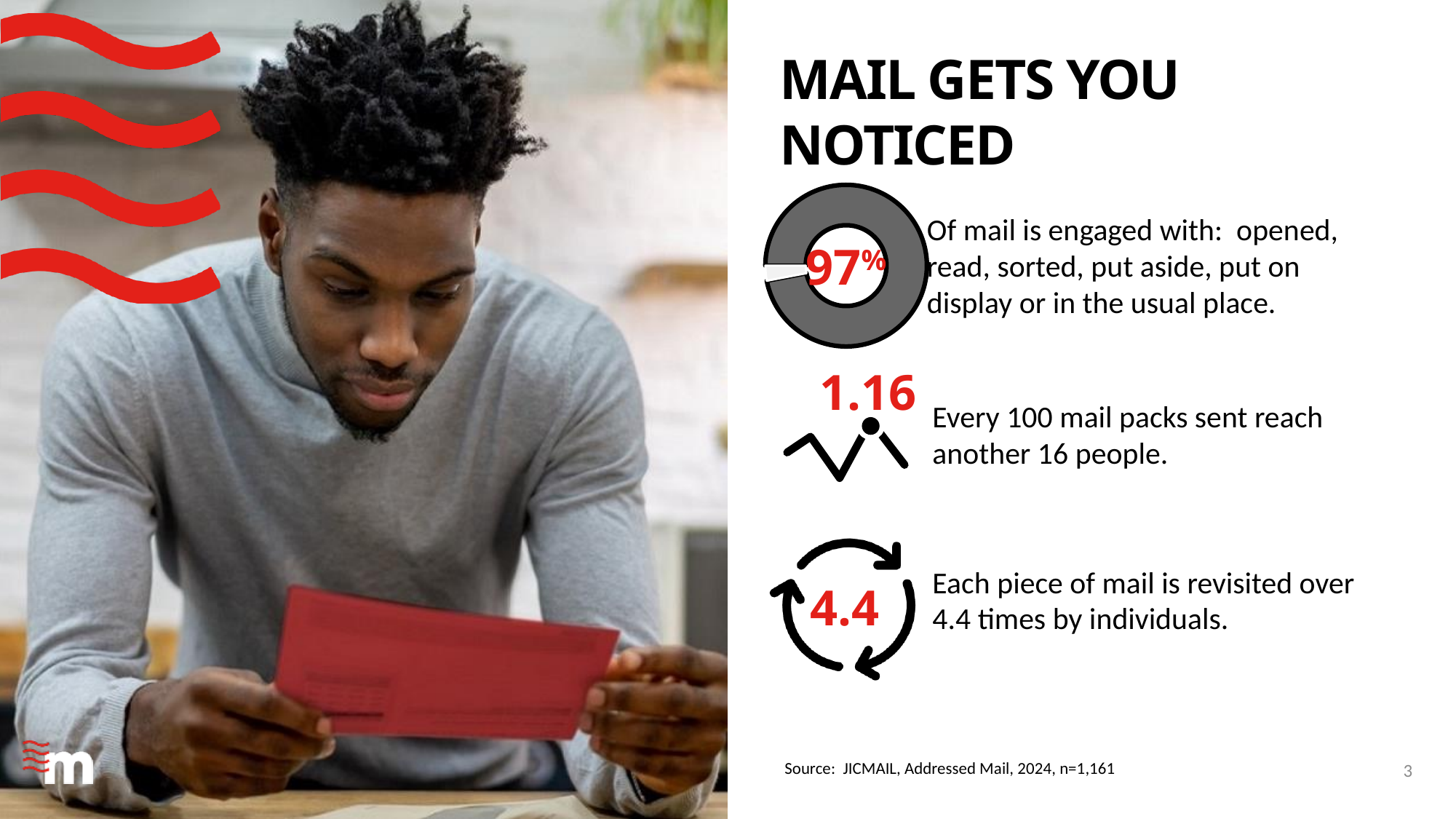
What percentage is shown in the centre of the donut chart? 97% Is the value shown in the donut chart greater or less than 90%? greater What kind of chart is used to show the 97% figure? Donut (pie) chart What colour is the large slice of the donut chart? Grey What is the title of the slide containing the donut chart? MAIL GETS YOU NOTICED What share of mail does the donut chart show is engaged with? 97% How many slices does the donut chart have? 2